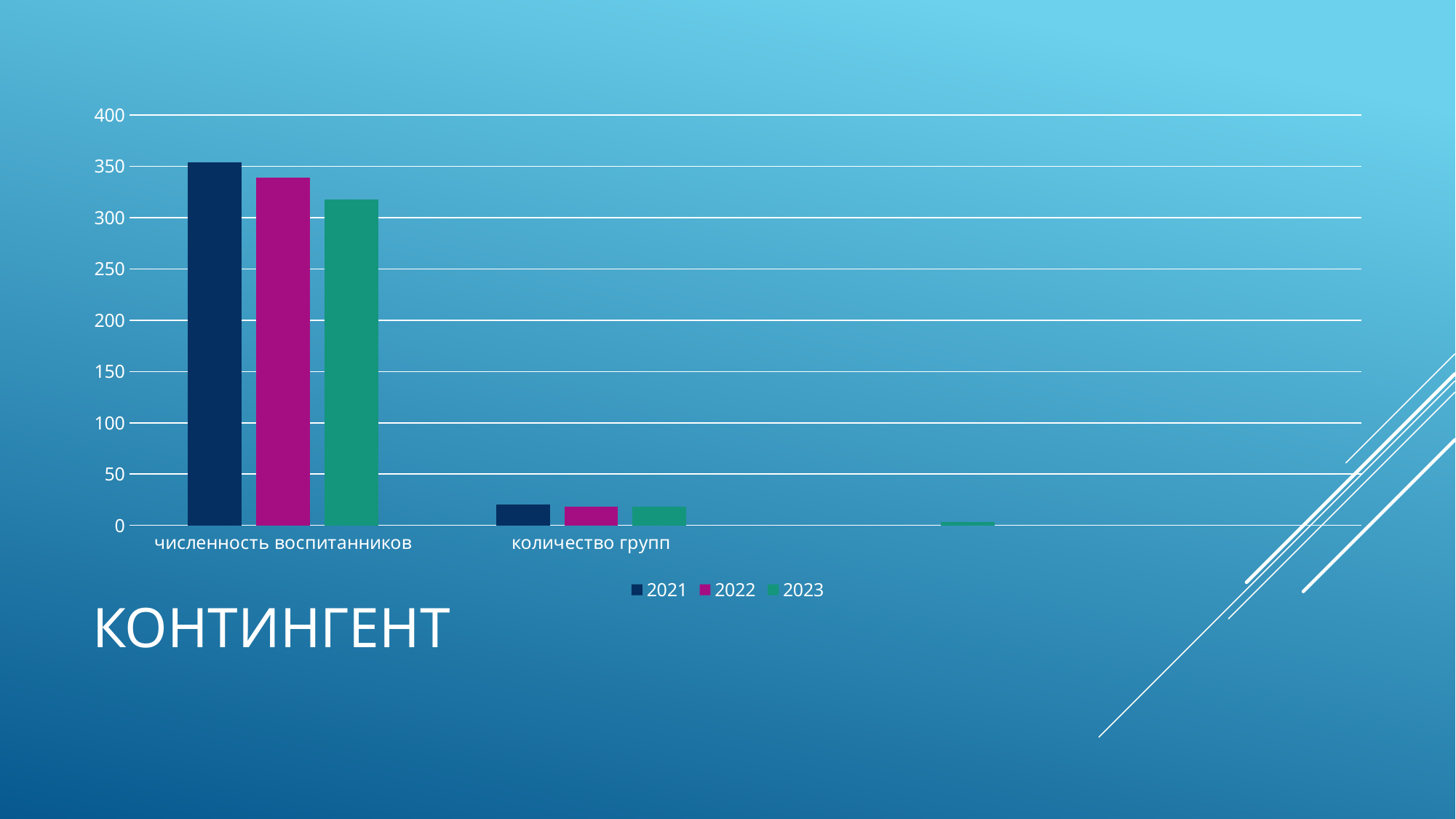
Is the value for количество групп in 2021 greater or less than 50? less Is the value for численность воспитанников in 2022 greater or less than 300? greater Which year has the lowest value for численность воспитанников? 2023 How many series does the legend list? 3 Do the values for численность воспитанников rise or fall from 2021 to 2023? fall Is the value for численность воспитанников in 2023 greater or less than 350? less Which is larger: численность воспитанников in 2021 or in 2023? 2021 What is the title shown below the chart? КОНТИНГЕНТ What kind of chart is shown on the slide? bar chart Which year has the highest value for численность воспитанников? 2021 Which years are listed in the chart legend? 2021, 2022, 2023